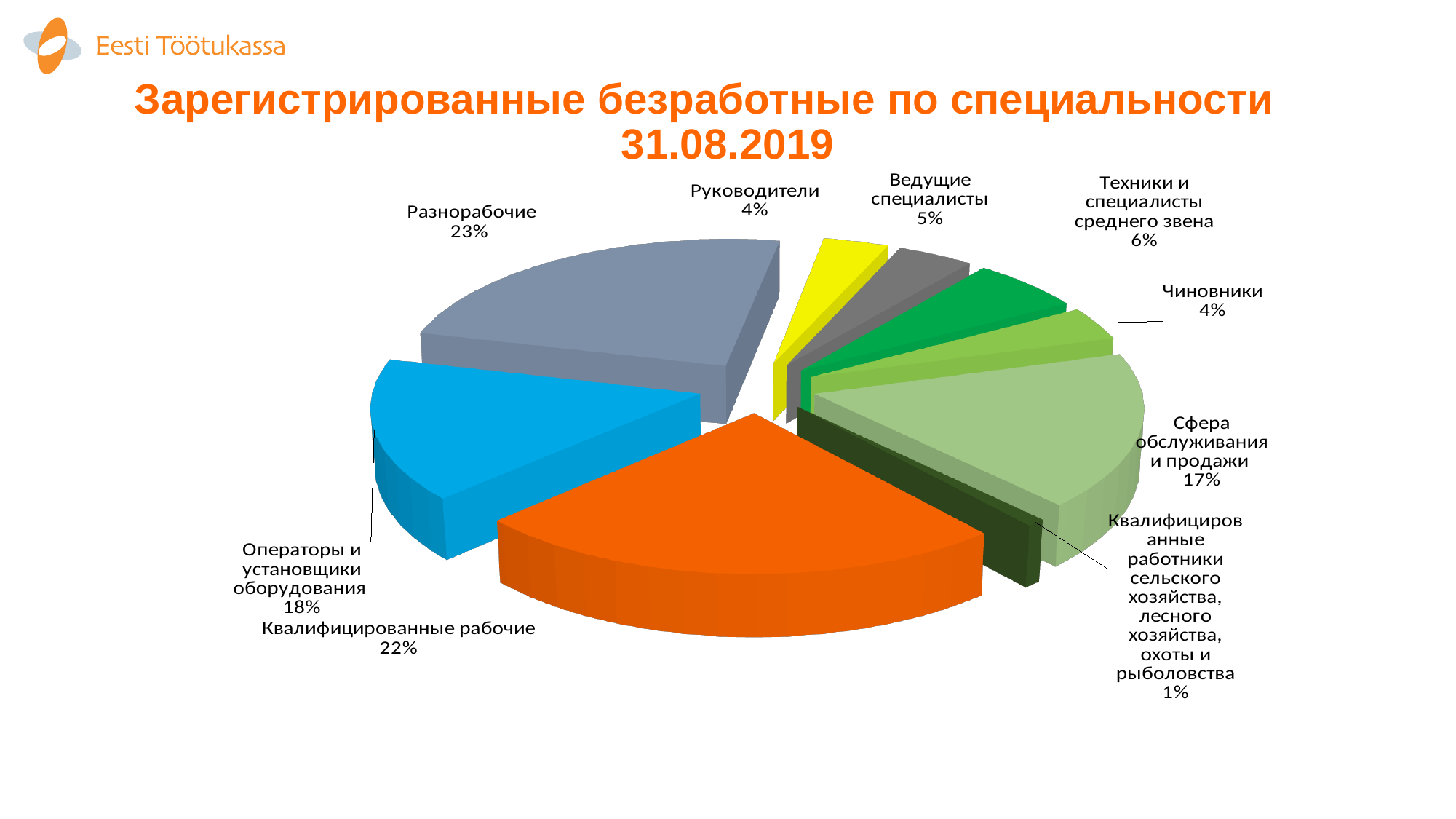
What is the difference in percentage points between Квалифицированные рабочие and Операторы и установщики оборудования? 4 What kind of chart is shown on the slide? Pie chart How many categories are shown in the pie chart? 9 What is the date given in the chart title? 31.08.2019 What percentage is shown for Техники и специалисты среднего звена? 6% What percentage is shown for Сфера обслуживания и продажи? 17% What percentage is shown for Операторы и установщики оборудования? 18% What share of registered unemployed is labelled for Разнорабочие? 23% Which is larger: the share for Ведущие специалисты or the share for Руководители? Ведущие специалисты What colour is the slice for Квалифицированные рабочие? Orange Which category has the smallest share of the pie? Квалифицированные работники сельского хозяйства, лесного хозяйства, охоты и рыболовства Which category has the largest share of the pie? Разнорабочие